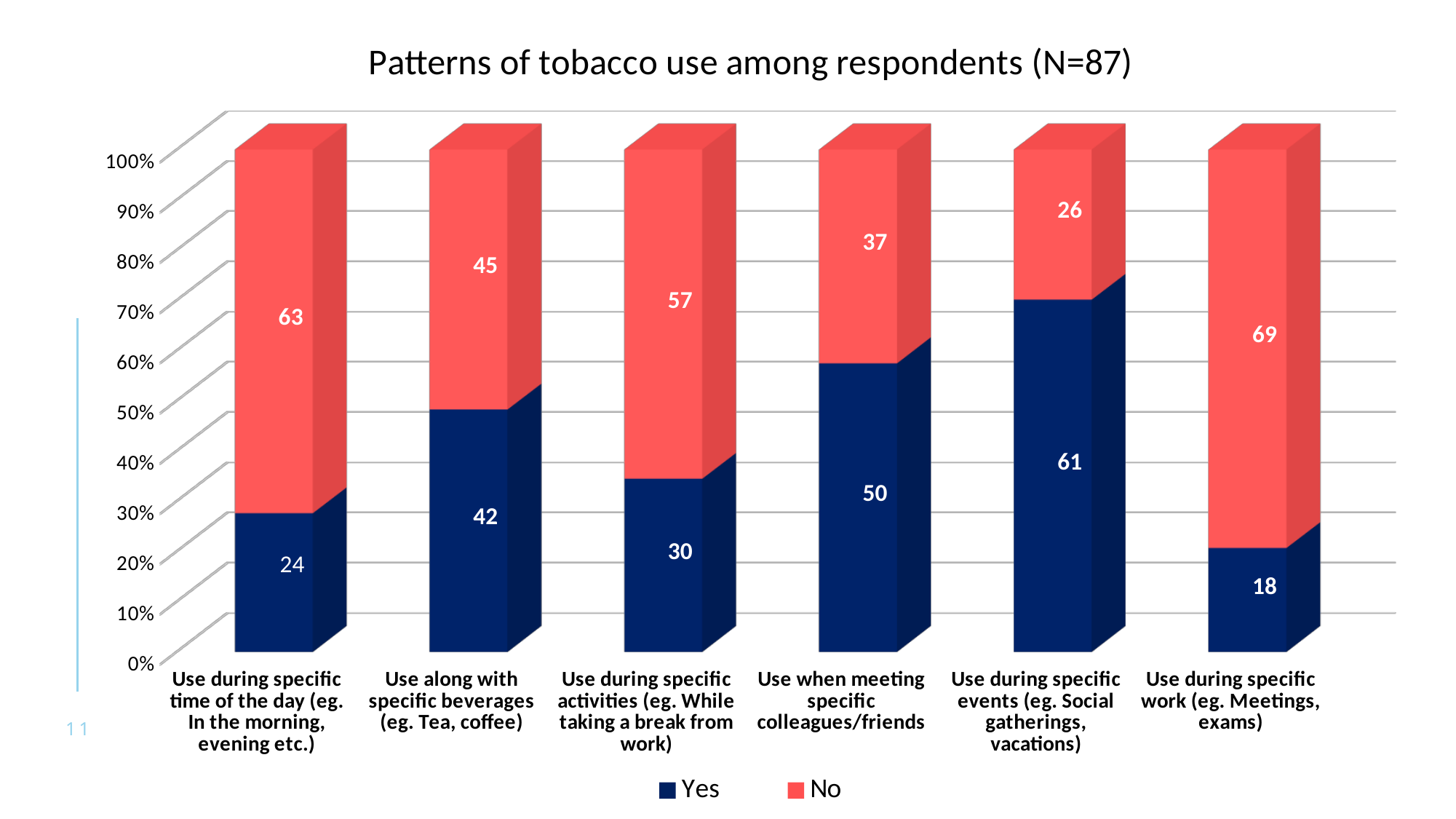
What type of chart is shown on the slide? Stacked bar chart What is the 'No' value for 'Use during specific work (eg. Meetings, exams)'? 69 What is the chart title? Patterns of tobacco use among respondents (N=87) How many categories are shown on the x axis? 6 What is the total of the stacked bar for 'Use during specific time of the day (eg. In the morning, evening etc.)'? 87 Which is larger for 'Use when meeting specific colleagues/friends': the 'Yes' value or the 'No' value? Yes What is the 'Yes' value for 'Use along with specific beverages (eg. Tea, coffee)'? 42 What is the difference between the 'No' and 'Yes' values for 'Use during specific activities (eg. While taking a break from work)'? 27 Which category has the lowest 'Yes' value? Use during specific work (eg. Meetings, exams) How many series does the legend list? 2 Which category has the highest 'Yes' value? Use during specific events (eg. Social gatherings, vacations) Which colour represents the 'No' series in the legend? Red